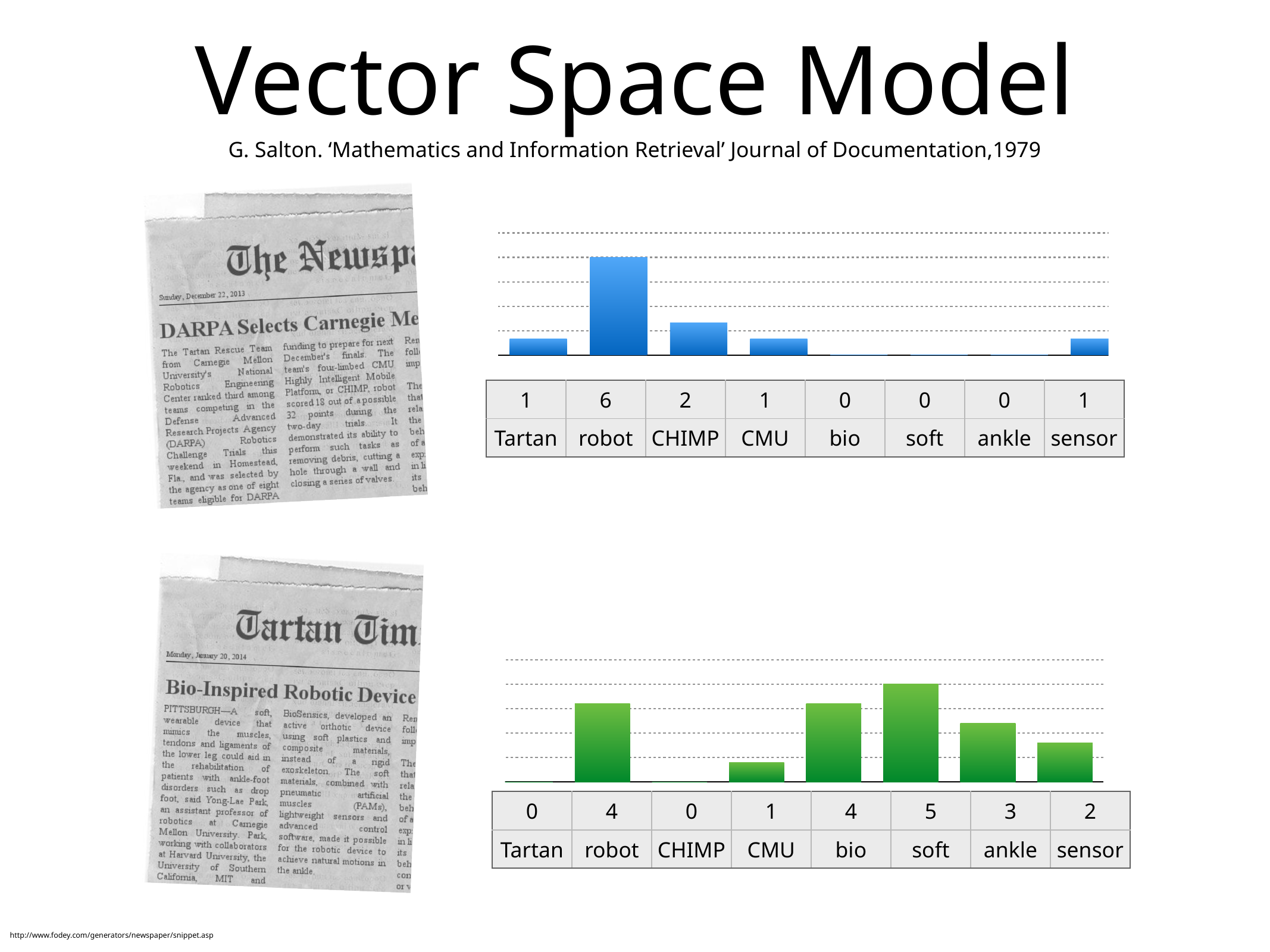
In the bottom (green) bar chart, what is the value for soft? 5 In the top (blue) bar chart, what is the value for CHIMP? 2 In the bottom (green) bar chart, which category has the highest value? soft In the bottom (green) bar chart, which is larger, the value for bio or the value for sensor? bio In the top (blue) bar chart, what is the difference between the values for robot and CHIMP? 4 In the bottom (green) bar chart, what is the value for ankle? 3 What kind of chart is the bottom (green) chart? bar chart In the bottom (green) bar chart, what is the difference between the values for soft and CMU? 4 What colour are the bars in the top chart? blue In the top (blue) bar chart, how many categories are shown? 8 In the top (blue) bar chart, which category has the highest value? robot In the top (blue) bar chart, what is the value for robot? 6